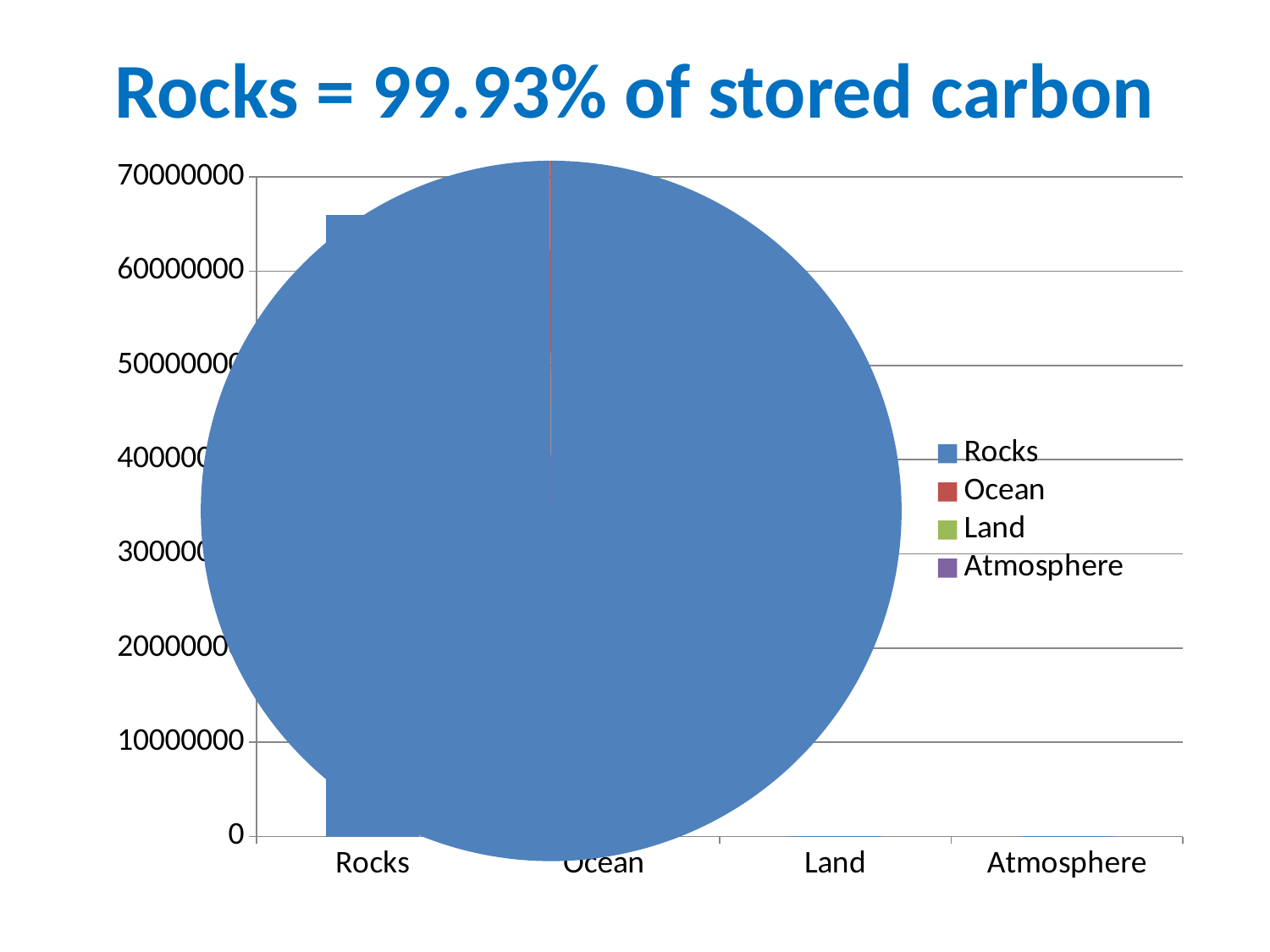
What is the highest tick value shown on the y axis of the bar chart? 70000000 In the bar chart, is the value for Atmosphere greater or less than 10000000? less In the bar chart, is the value for Land greater or less than 10000000? less According to the slide title, what share of stored carbon is in rocks? 99.93% In the bar chart, which is larger, the value for Rocks or the value for Atmosphere? Rocks How many entries does the legend list? 4 What kind of chart is overlaid in the centre of the slide? pie chart How many categories are labelled on the x axis of the bar chart? 4 In the bar chart, is the value for Rocks greater or less than 60000000? greater What kind of chart is drawn behind the pie on this slide? bar chart In the bar chart, which category has the highest value? Rocks